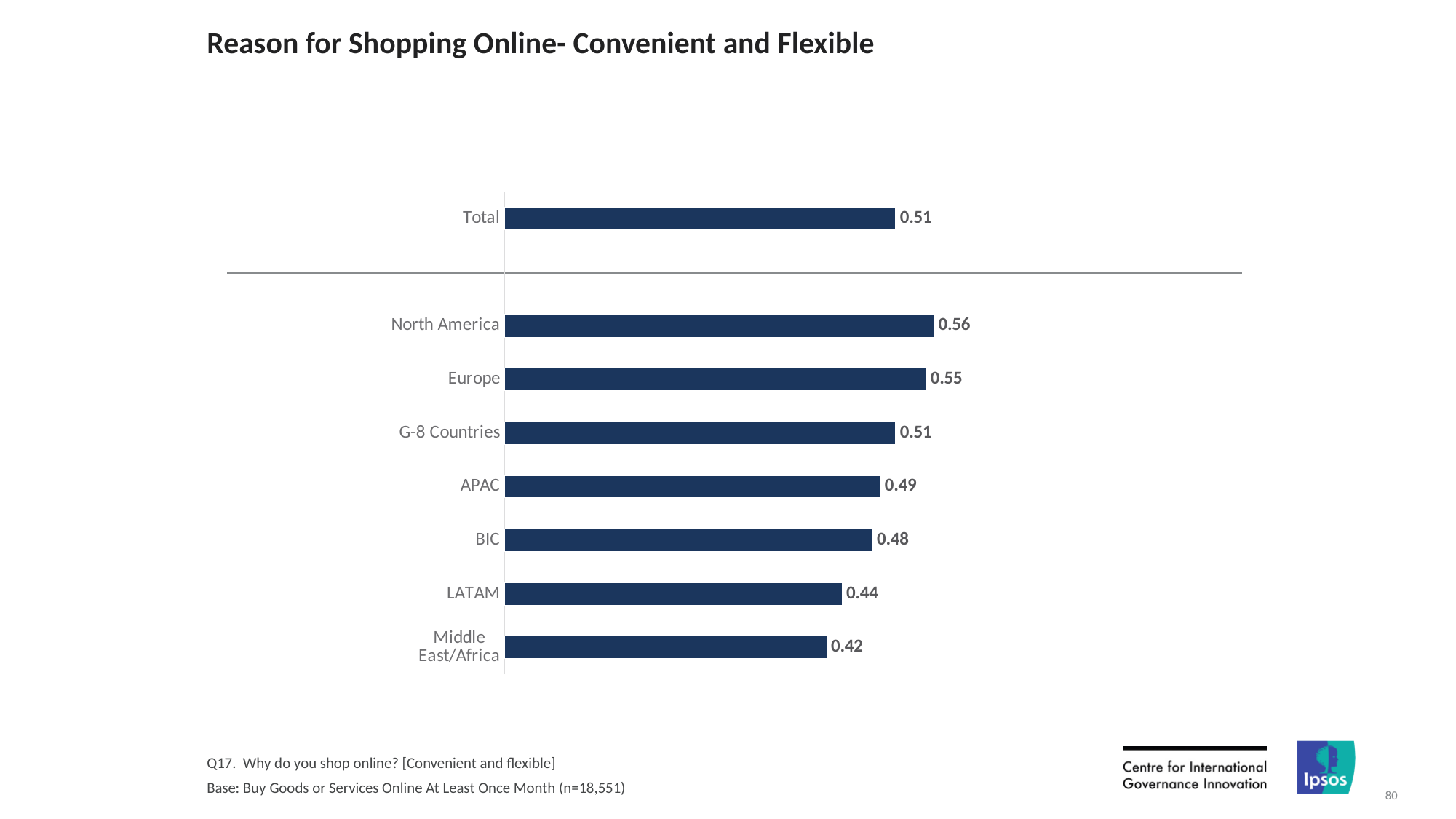
What is the difference between the values for North America and LATAM? 0.12 What is the title of the chart? Reason for Shopping Online- Convenient and Flexible What is the difference between the values for Europe and APAC? 0.06 What is the value for Middle East/Africa? 0.42 What is the value for BIC? 0.48 Which is larger, the value for APAC or the value for LATAM? APAC Which region has the highest value? North America How many bars are plotted in the chart, including Total? 8 What is the value for the Total bar? 0.51 What is the value for North America? 0.56 What kind of chart is shown on the slide? Bar chart Which region has the lowest value? Middle East/Africa